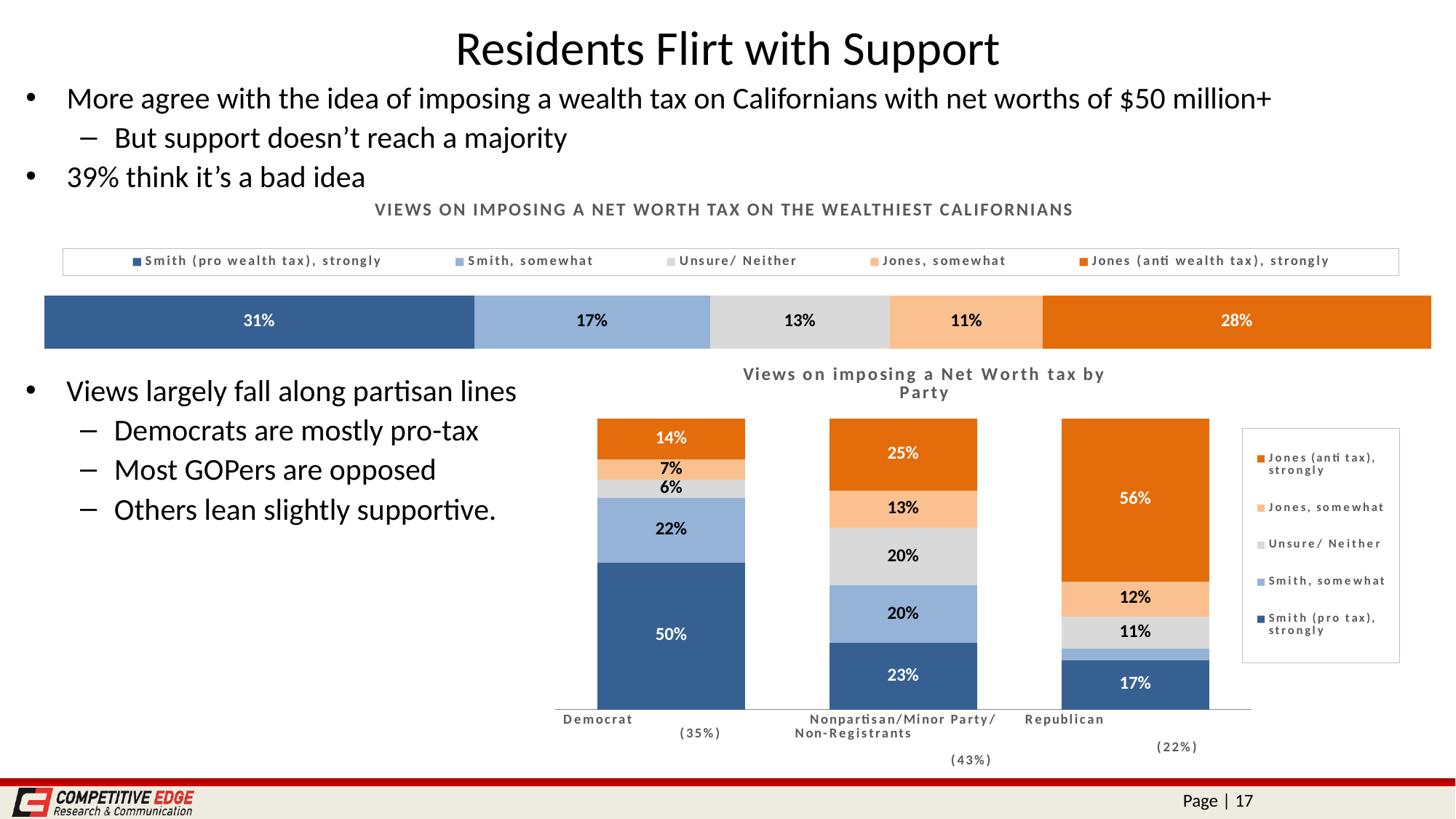
In the bottom chart, 'Views on imposing a Net Worth tax by Party', what percentage of Democrats are 'Smith (pro tax), strongly'? 50% In the top chart, which segment has the smallest percentage? Jones, somewhat In the bottom chart, what percentage of Nonpartisan/Minor Party/Non-Registrants are 'Unsure/ Neither'? 20% In the top chart, 'Views on imposing a net worth tax on the wealthiest Californians', what percentage is shown for 'Smith (pro wealth tax), strongly'? 31% In the top chart, what is the difference between 'Smith (pro wealth tax), strongly' and 'Jones (anti wealth tax), strongly'? 3% How many series does the legend of the top chart list? 5 In the top chart, what percentage is shown for 'Jones (anti wealth tax), strongly'? 28% How many party categories are shown on the x axis of the bottom chart? 3 In the bottom chart, what percentage of Republicans are 'Jones (anti tax), strongly'? 56% In the bottom chart, is the 'Smith (pro tax), strongly' value larger for Democrats or for Republicans? Democrats In the top chart, what percentage is 'Unsure/ Neither'? 13% In the bottom chart, which party group has the highest 'Jones (anti tax), strongly' share? Republican